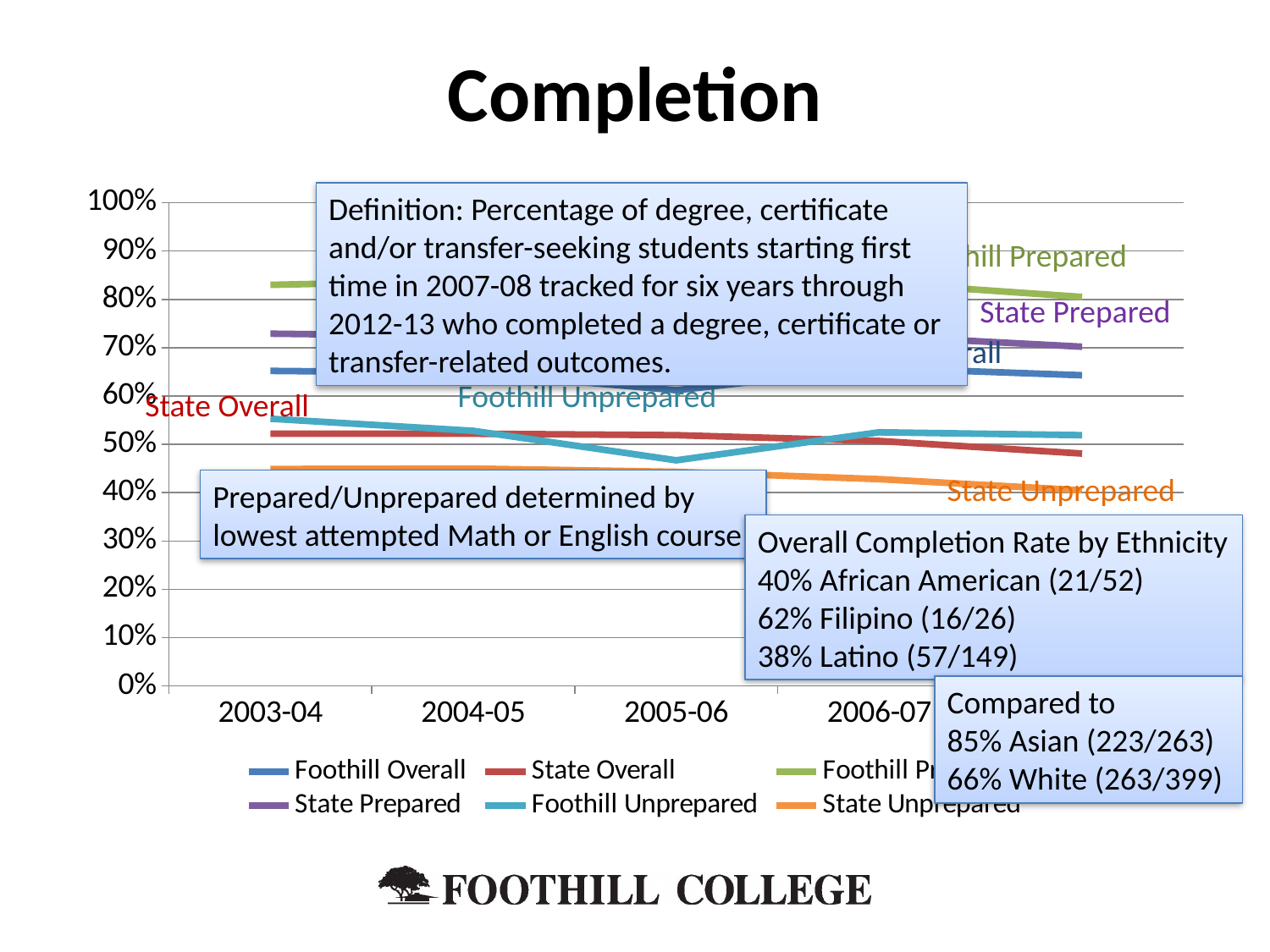
Is the value for State Unprepared in 2006-07 greater or less than 50%? less Is the value for Foothill Prepared in 2003-04 greater or less than 80%? greater Which series has the lowest value in 2003-04? State Unprepared Does the State Unprepared line rise or fall from 2003-04 to 2006-07? fall In 2003-04, which is larger: Foothill Unprepared or State Unprepared? Foothill Unprepared Which series has the highest value in 2003-04? Foothill Prepared How many series does the chart legend list? 6 What is the title of the slide containing the chart? Completion Is the value for State Prepared in 2003-04 greater or less than 70%? greater What kind of chart is shown on the slide? line chart In 2003-04, which is larger: Foothill Overall or State Overall? Foothill Overall